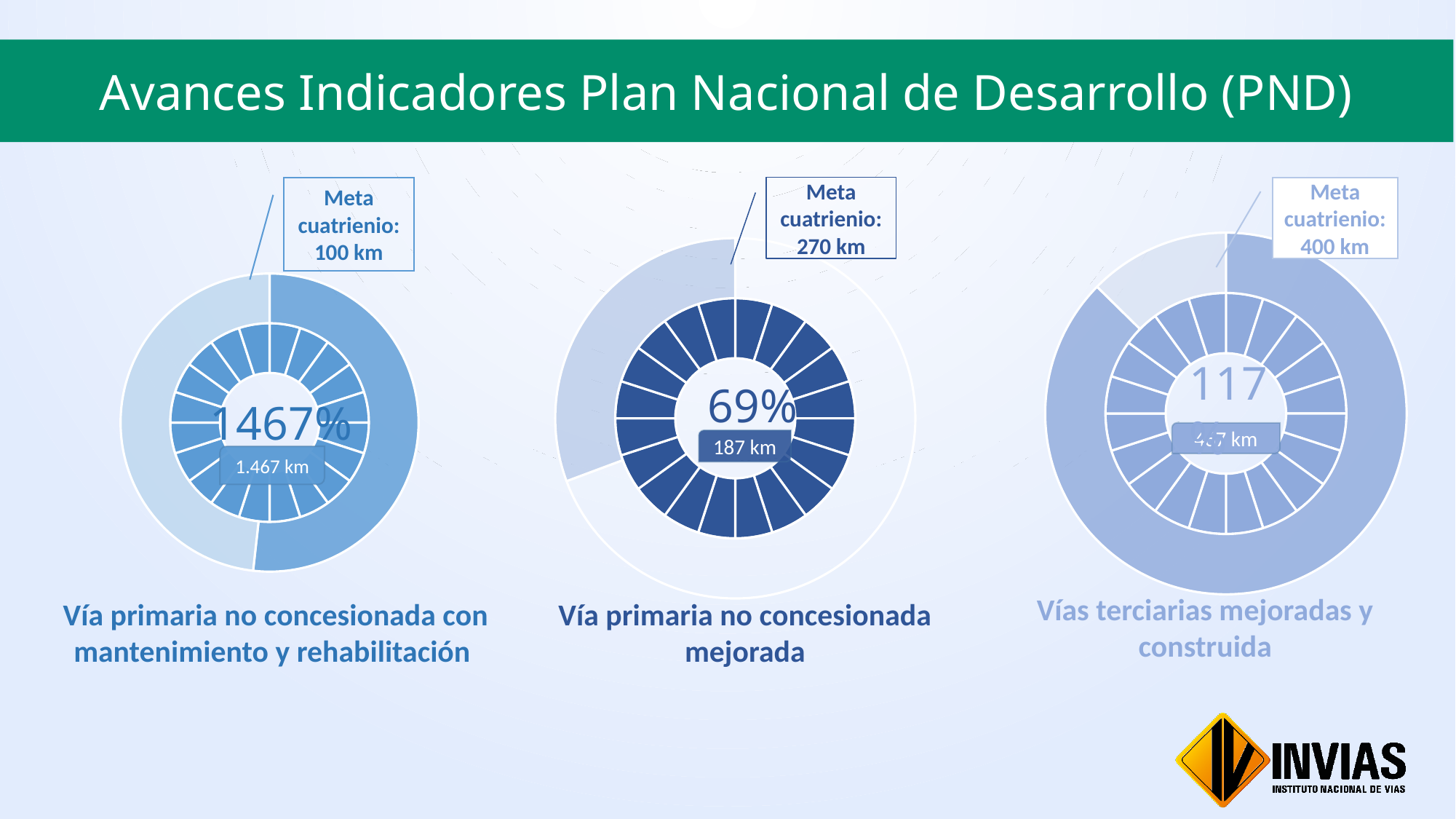
On the chart titled 'Vía primaria no concesionada mejorada', what percentage is shown in the centre? 69% Which chart shows the higher percentage, 'Vía primaria no concesionada con mantenimiento y rehabilitación' or 'Vía primaria no concesionada mejorada'? Vía primaria no concesionada con mantenimiento y rehabilitación On the chart titled 'Vía primaria no concesionada con mantenimiento y rehabilitación', how many km are shown in the centre label? 1.467 km On the chart titled 'Vía primaria no concesionada mejorada', what is the 'Meta cuatrienio'? 270 km On the chart titled 'Vía primaria no concesionada mejorada', how many km are shown in the centre label? 187 km How many charts are shown on the slide? 3 On the chart titled 'Vías terciarias mejoradas y construida', what is the 'Meta cuatrienio'? 400 km On the chart titled 'Vía primaria no concesionada con mantenimiento y rehabilitación', what percentage is shown in the centre? 1467% On the chart titled 'Vía primaria no concesionada mejorada', how many km short of the 'Meta cuatrienio' is the 187 km achieved? 83 km On the chart titled 'Vía primaria no concesionada con mantenimiento y rehabilitación', what is the 'Meta cuatrienio'? 100 km Which of the three charts has the largest 'Meta cuatrienio'? Vías terciarias mejoradas y construida What kind of chart is used for each indicator on the slide? Donut (pie) chart